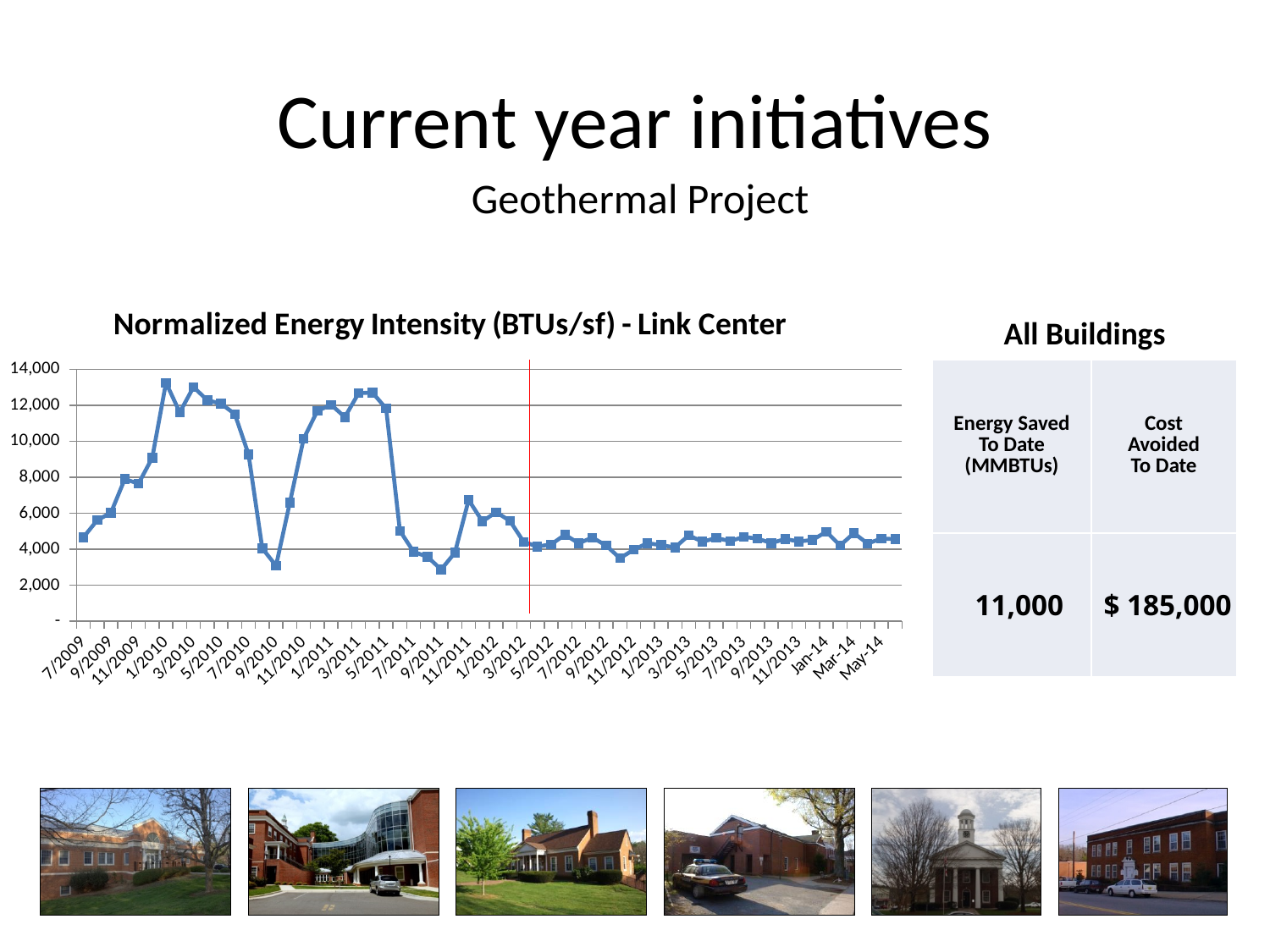
Is the value for 9/2010 greater or less than 4,000? less Is the value for 11/2011 greater or less than 6,000? greater Which is larger, the value for 9/2011 or the value for 11/2011? 11/2011 Is the value for 1/2010 greater or less than 12,000? greater What is the title of the chart? Normalized Energy Intensity (BTUs/sf) - Link Center What is the highest value shown on the vertical axis of the chart? 14,000 Do the values rise or fall from 7/2009 to 1/2010? rise Do the values rise or fall from 5/2011 to 9/2011? fall Which is larger, the value for 1/2010 or the value for 9/2010? 1/2010 What kind of chart is shown on the slide? line chart